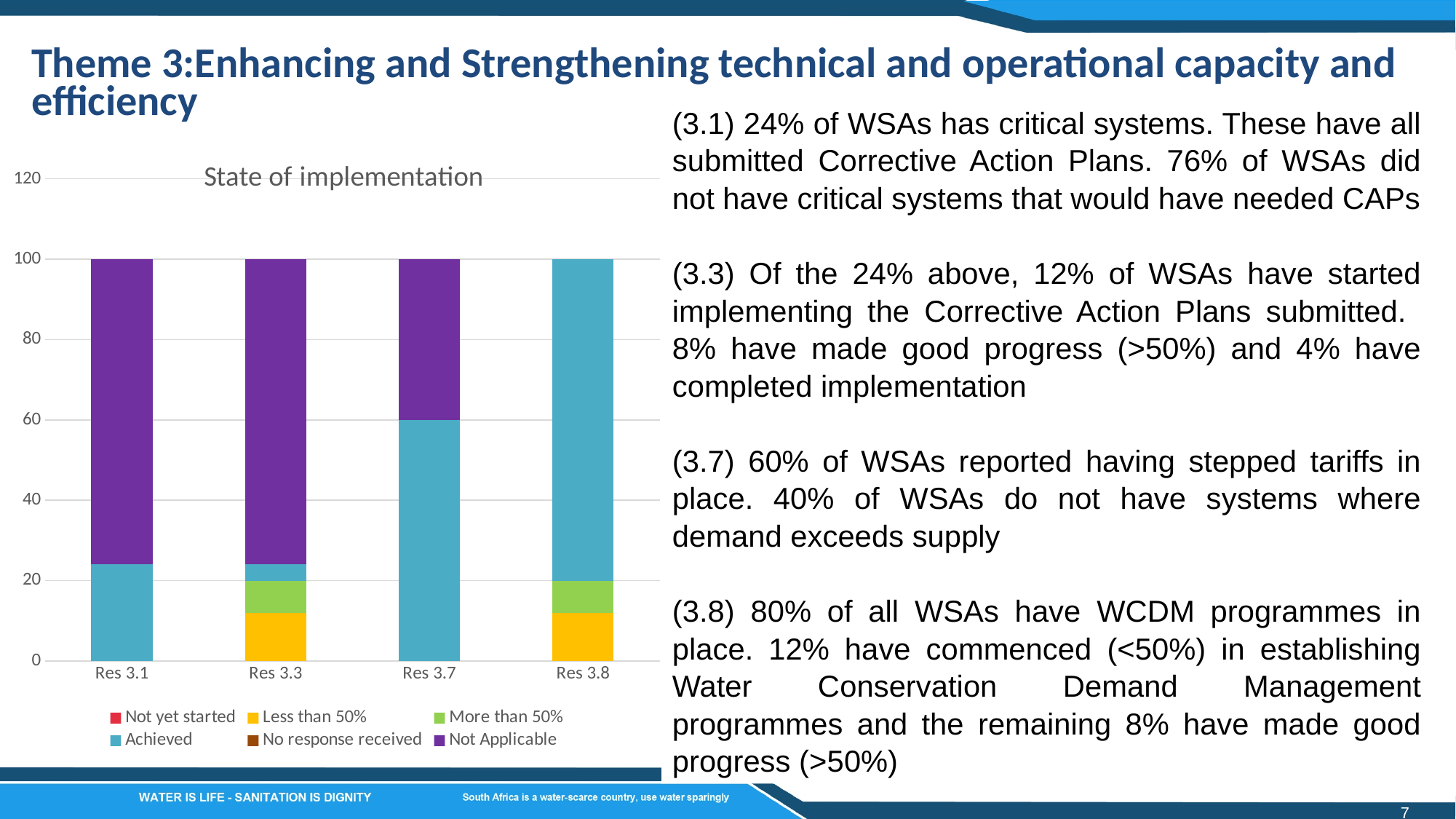
Which category has no Not Applicable segment in its bar? Res 3.8 Is the Achieved value for Res 3.8 greater or less than 60? greater What is the total height of the stacked bar for Res 3.7? 100 Is the Achieved value for Res 3.1 greater or less than 20? greater What type of chart is shown on the slide? Stacked bar chart What is the title of the chart? State of implementation Which category has the largest Achieved segment? Res 3.8 How many categories are shown on the x axis of the chart? 4 Is the Less than 50% value for Res 3.3 greater or less than 20? less Which has a larger Achieved segment, Res 3.1 or Res 3.7? Res 3.7 How many series does the chart legend list? 6 What value does the Achieved segment for Res 3.7 reach on the y axis? 60